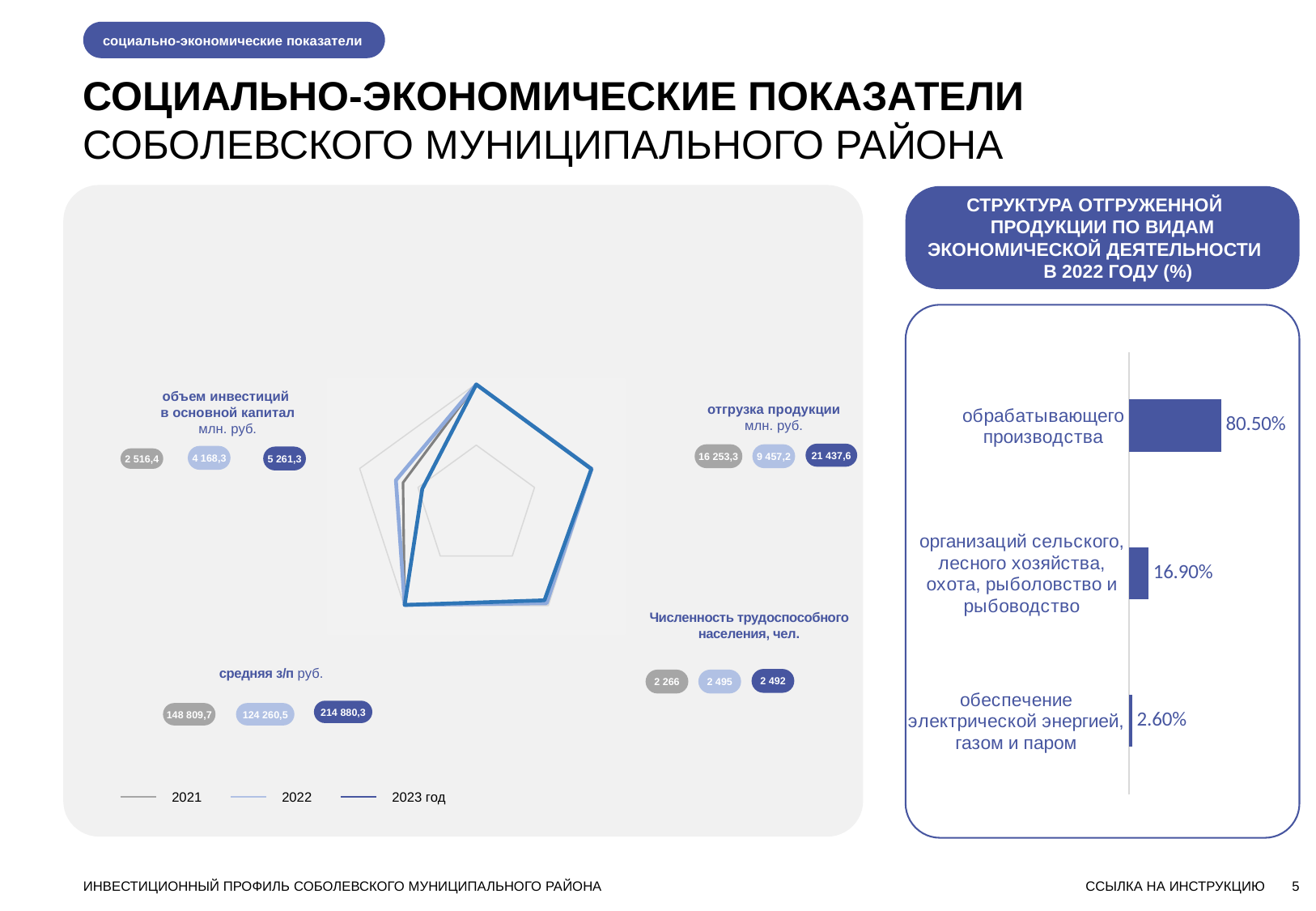
What kind of chart is the chart on the right-hand side of the slide? bar chart On the left-hand radar chart, what is the value of объем инвестиций в основной капитал for 2023? 5 261,3 On the left-hand radar chart, what is the value of отгрузка продукции for 2022? 9 457,2 On the left-hand radar chart, what is the value of средняя з/п for 2021? 148 809,7 On the left-hand radar chart, which is larger: отгрузка продукции in 2021 or in 2022? 2021 On the right-hand bar chart, what is the value for обрабатывающего производства? 80.50% On the right-hand bar chart, which category has the lowest value? обеспечение электрической энергией, газом и паром On the right-hand bar chart, what is the value for обеспечение электрической энергией, газом и паром? 2.60% On the left-hand radar chart, how many series does the legend list? 3 On the right-hand bar chart, what is the difference between the values for обрабатывающего производства and организаций сельского, лесного хозяйства, охота, рыболовство и рыбоводство? 63.60% On the right-hand bar chart, which category has the highest value? обрабатывающего производства On the right-hand bar chart, how many categories are shown? 3